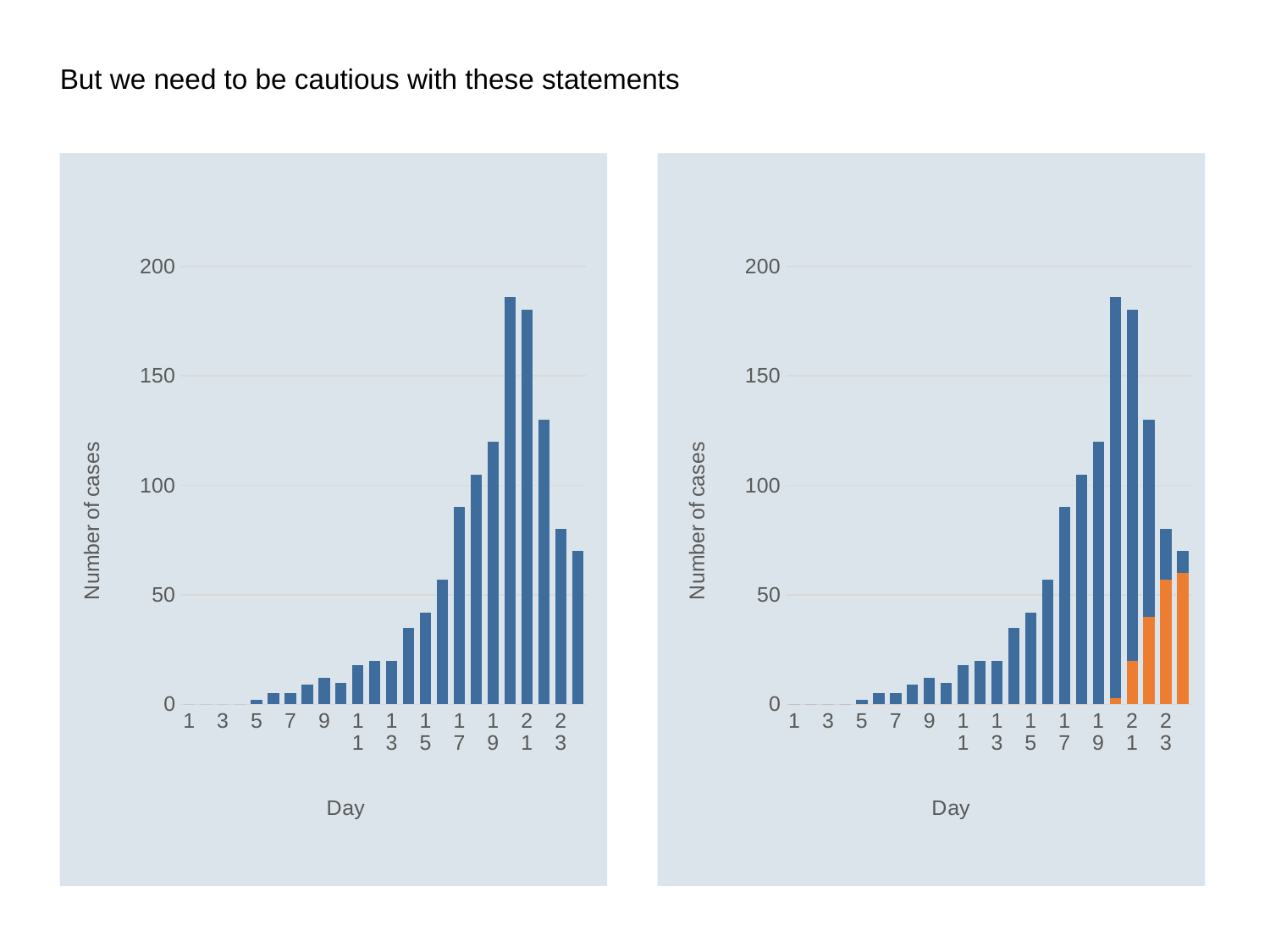
On the left chart, do the values rise or fall from day 5 to day 20? rise On the right chart, which is larger, the total for day 22 or the total for day 24? Day 22 On the left chart, which is larger, the value for day 19 or the value for day 23? Day 19 On the left chart, is the value for day 22 greater or less than 100? greater On the left chart, is the value for day 17 greater or less than 50? greater What type of chart is the left chart? bar chart What is the y-axis title of the right chart? Number of cases On the right chart, is the total value for day 20 greater or less than 150? greater On the right chart, what colour is the second segment stacked on top of the blue bars for the last few days? orange On the left chart, which day has the highest number of cases? Day 20